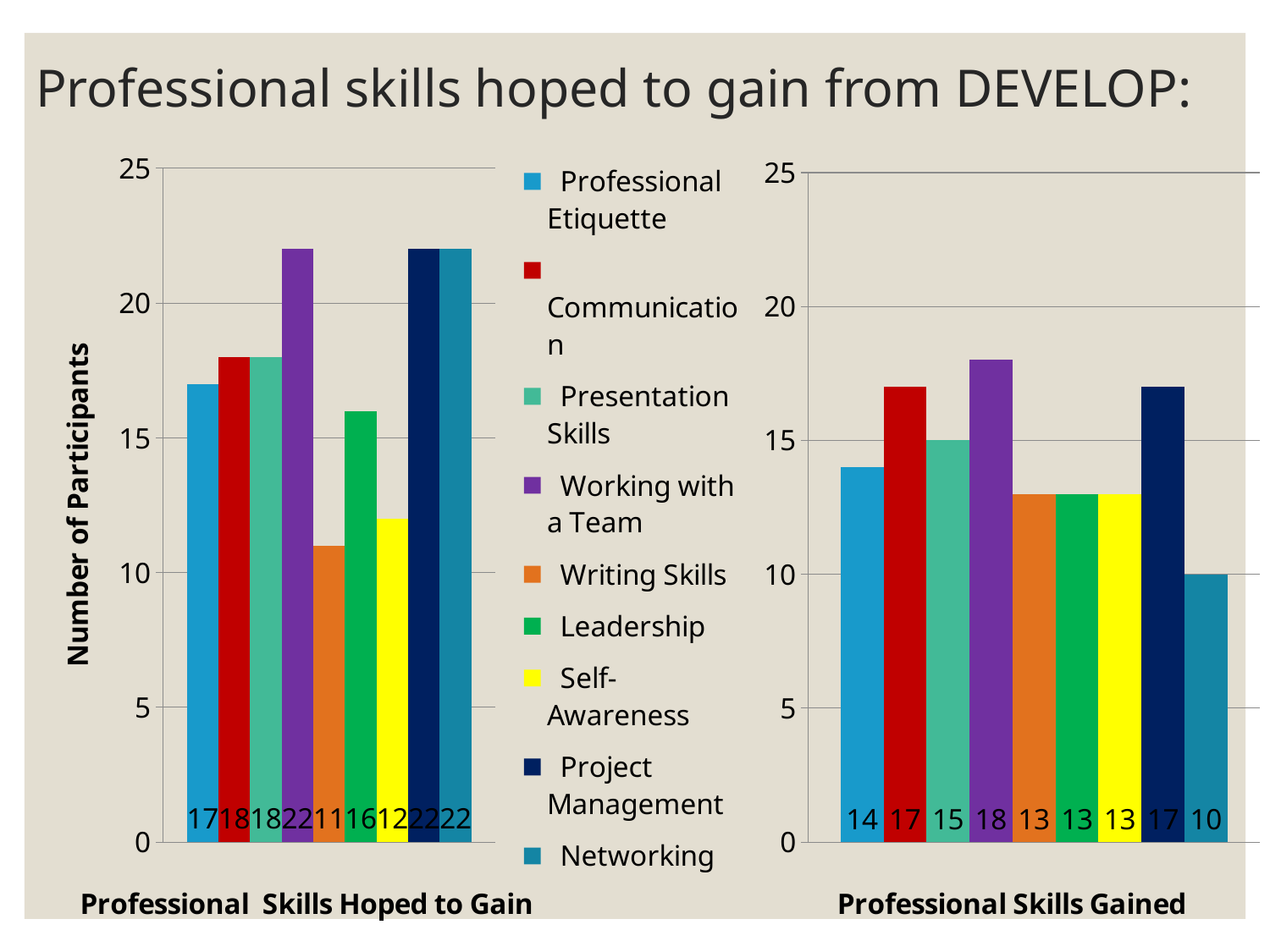
In the 'Professional Skills Gained' chart, what is the difference between Communication and Networking? 7 In the 'Professional Skills Gained' chart, what is the value for Networking? 10 In the 'Professional Skills Gained' chart, which is larger, Professional Etiquette or Presentation Skills? Presentation Skills In the 'Professional Skills Hoped to Gain' chart, what is the value for Writing Skills? 11 In the 'Professional Skills Gained' chart, which series has the lowest value? Networking In the 'Professional Skills Hoped to Gain' chart, is the value for Leadership greater or less than 15? greater In the 'Professional Skills Hoped to Gain' chart, what is the difference between Working with a Team and Writing Skills? 11 What kind of chart is the 'Professional Skills Gained' chart? bar chart In the 'Professional Skills Hoped to Gain' chart, which series has the lowest value? Writing Skills How many series does the legend list? 9 In the 'Professional Skills Gained' chart, which series has the highest value? Working with a Team In the 'Professional Skills Gained' chart, what is the value for Working with a Team? 18